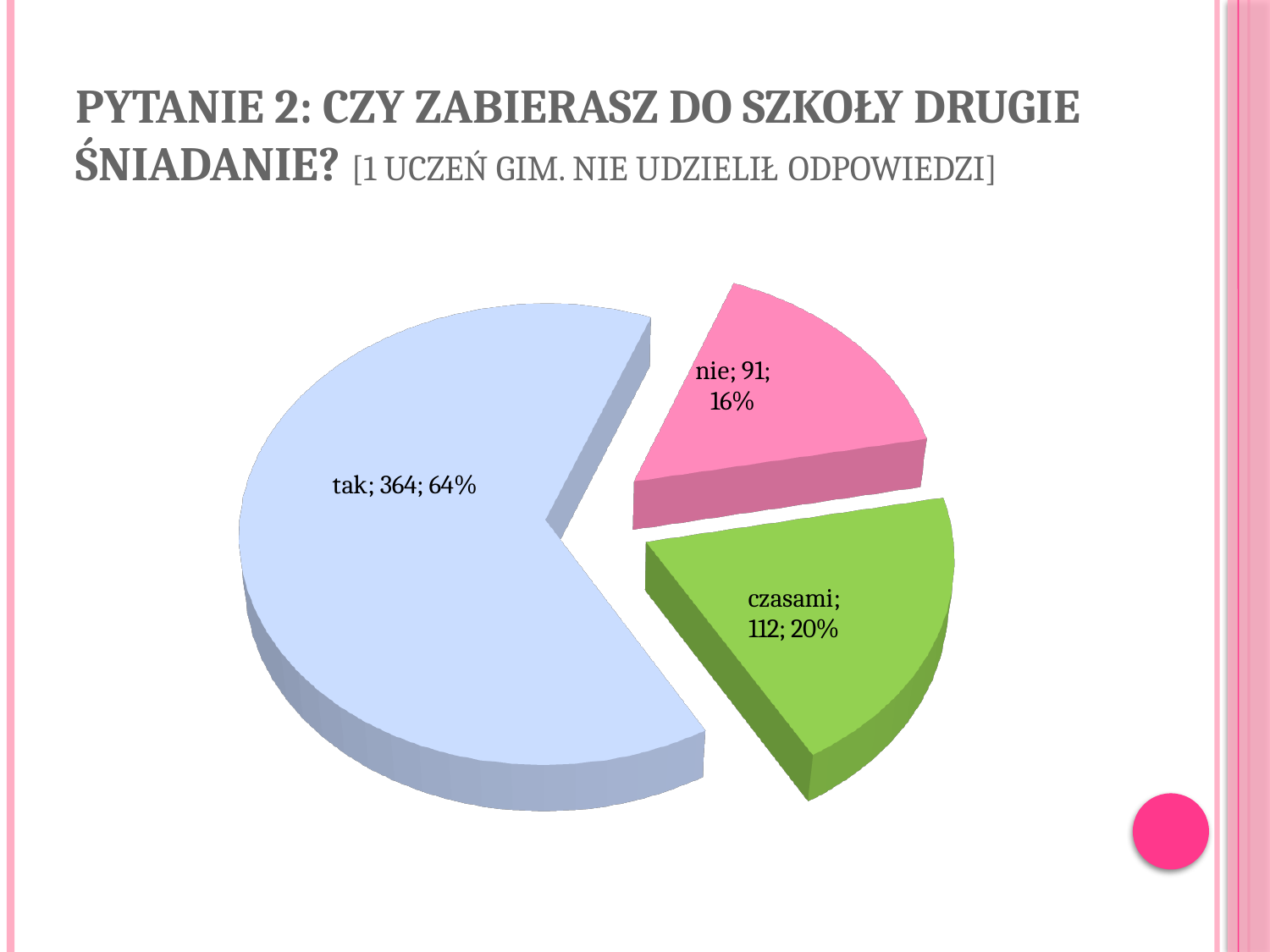
What share of the pie does "czasami" represent? 20% Which is larger, the value for "czasami" or the value for "nie"? czasami What is the value for "nie"? 91 What kind of chart is shown on the slide? pie chart How many slices does the pie chart have? 3 What is the difference between the values for "czasami" and "nie"? 21 Which category has the smallest slice? nie What is the value for "tak"? 364 Which category has the largest slice? tak What share of the pie does "tak" represent? 64% What is the value for "czasami"? 112 What colour is the "nie" slice? pink